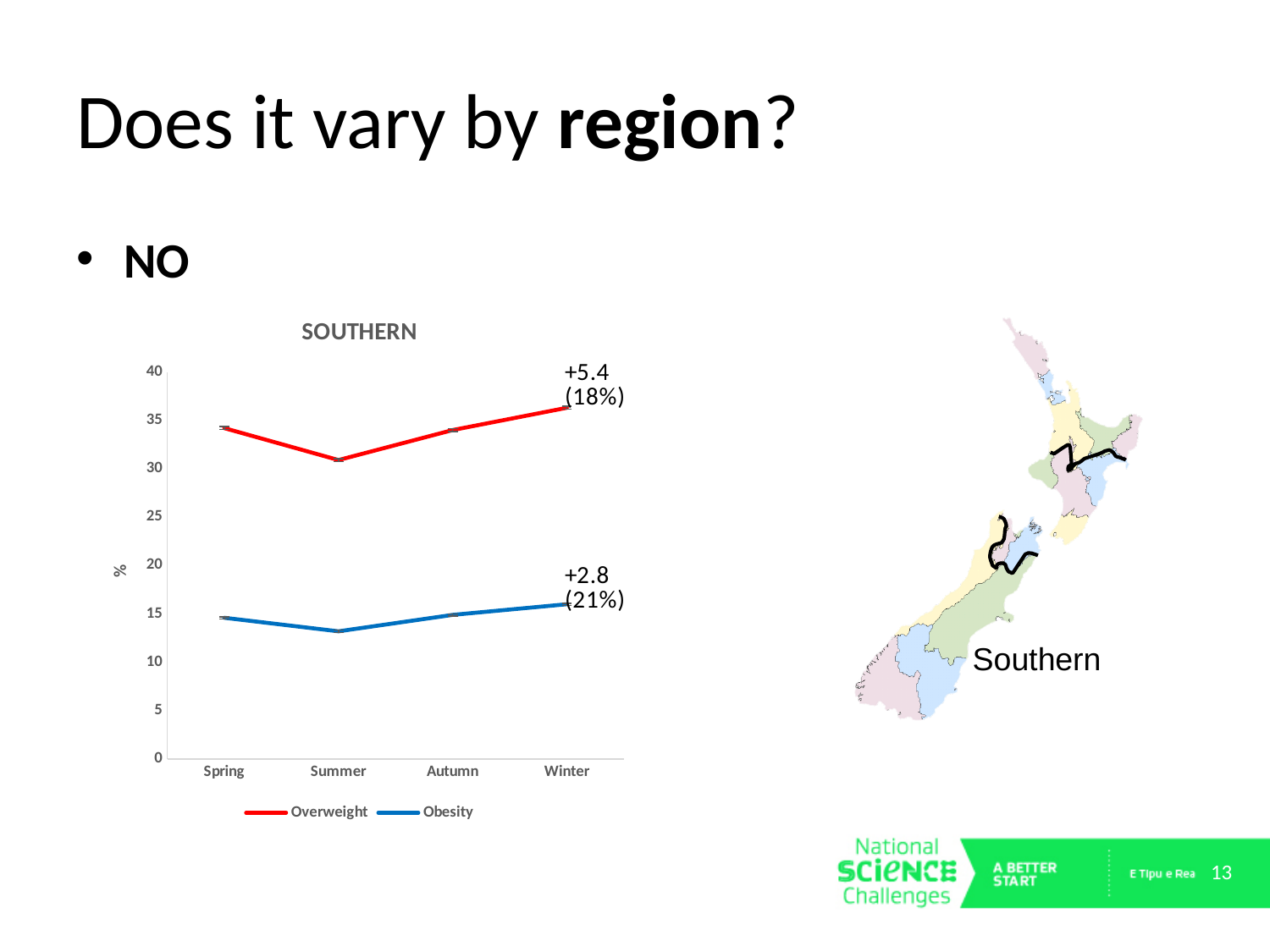
Do the Obesity values rise or fall from Summer to Winter? rise How many series does the chart's legend list? 2 Is the Obesity value for Summer greater or less than 15? less In which season is the Overweight value highest? Winter In which season is the Obesity value lowest? Summer In which season is the Overweight value lowest? Summer Is the Overweight value for Spring greater or less than 30? greater How many categories are shown on the x axis of the chart? 4 Is the Overweight value for Winter greater or less than 35? greater Which series has the larger value in Winter, Overweight or Obesity? Overweight What kind of chart is shown on the slide? line chart What is the title of the chart? SOUTHERN